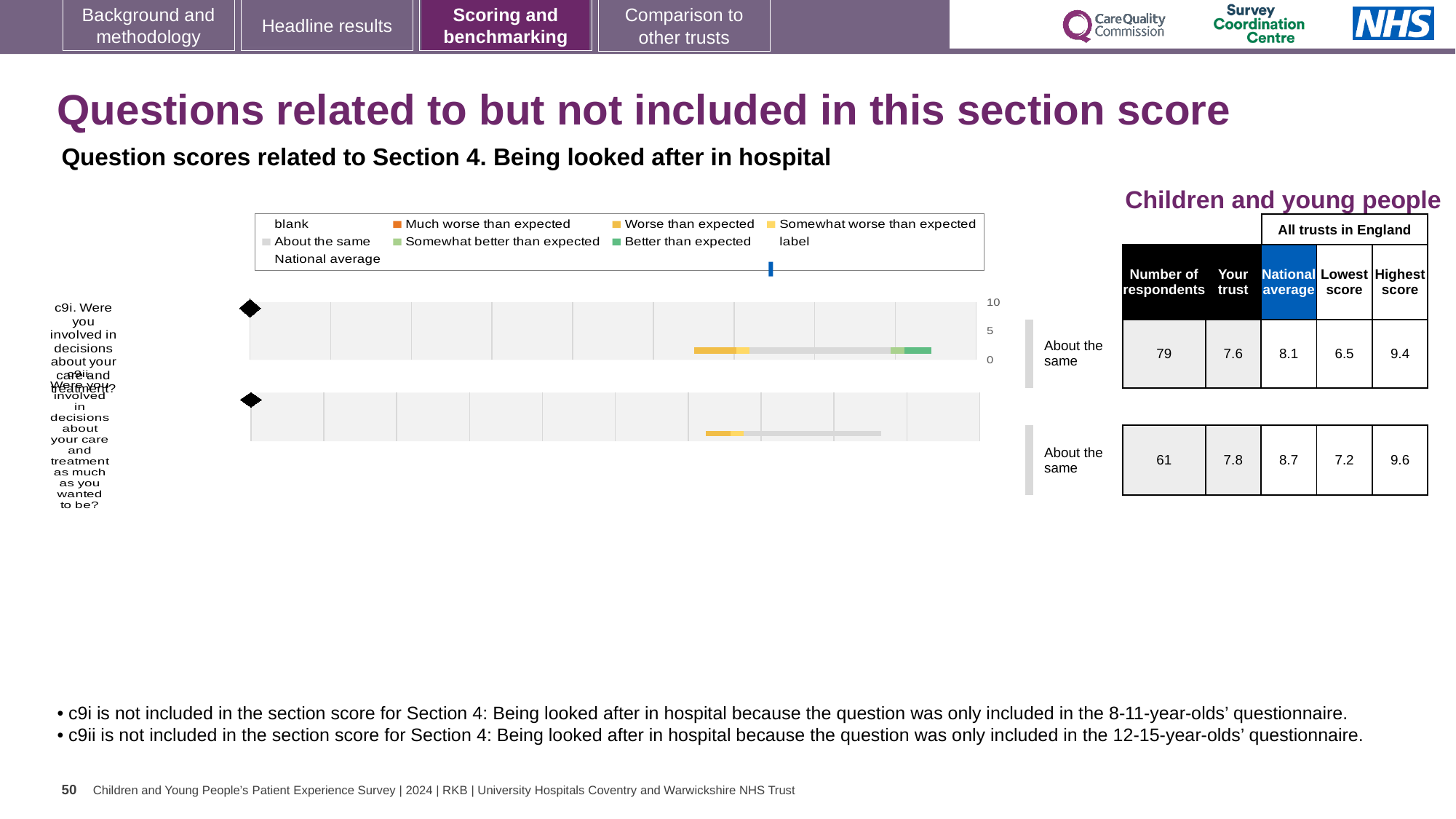
Which legend entry is shown with a dark orange marker? Much worse than expected What benchmark category is shown next to both c9i and c9ii? About the same According to the table, how many respondents answered c9i? 79 What is the difference between the national average and the 'Your trust' score for c9ii? 0.9 According to the table, what is the highest score across all trusts in England for c9ii? 9.6 What is the difference between the highest and lowest scores across all trusts for c9i? 2.9 Which question has the higher 'Your trust' score, c9i or c9ii? c9ii According to the table, what is the national average for c9ii? 8.7 What kind of chart is used to show the question scores for c9i and c9ii? bar chart How many questions (categories) are plotted in the chart? 2 According to the table, what is the 'Your trust' score for c9i? 7.6 What is the highest value shown on the chart's score axis? 10